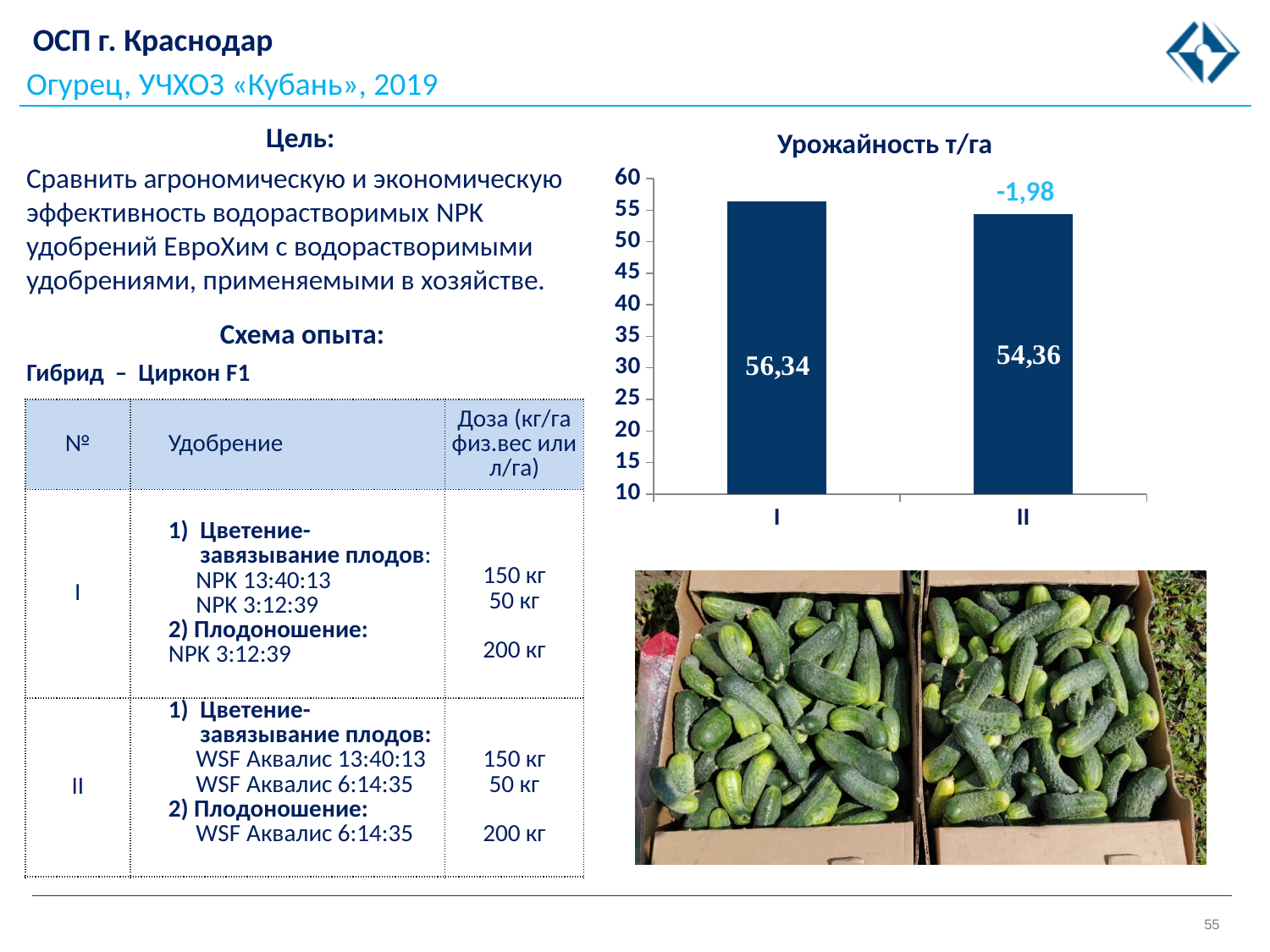
What is the yield value for category I in the 'Урожайность т/га' chart? 56,34 Which category has the lowest yield in the 'Урожайность т/га' chart? II Which category has the highest yield in the 'Урожайность т/га' chart? I What is the title of the chart on the slide? Урожайность т/га Is the yield for I in the 'Урожайность т/га' chart greater or less than 55? greater What is the difference between the yield for I and the yield for II in the 'Урожайность т/га' chart? 1,98 What kind of chart is the 'Урожайность т/га' chart? bar chart Which is larger in the 'Урожайность т/га' chart: the yield for I or for II? I Is the yield for II in the 'Урожайность т/га' chart greater or less than 55? less Do the values rise or fall from category I to category II in the 'Урожайность т/га' chart? fall How many categories are shown in the 'Урожайность т/га' chart? 2 What is the yield value for category II in the 'Урожайность т/га' chart? 54,36